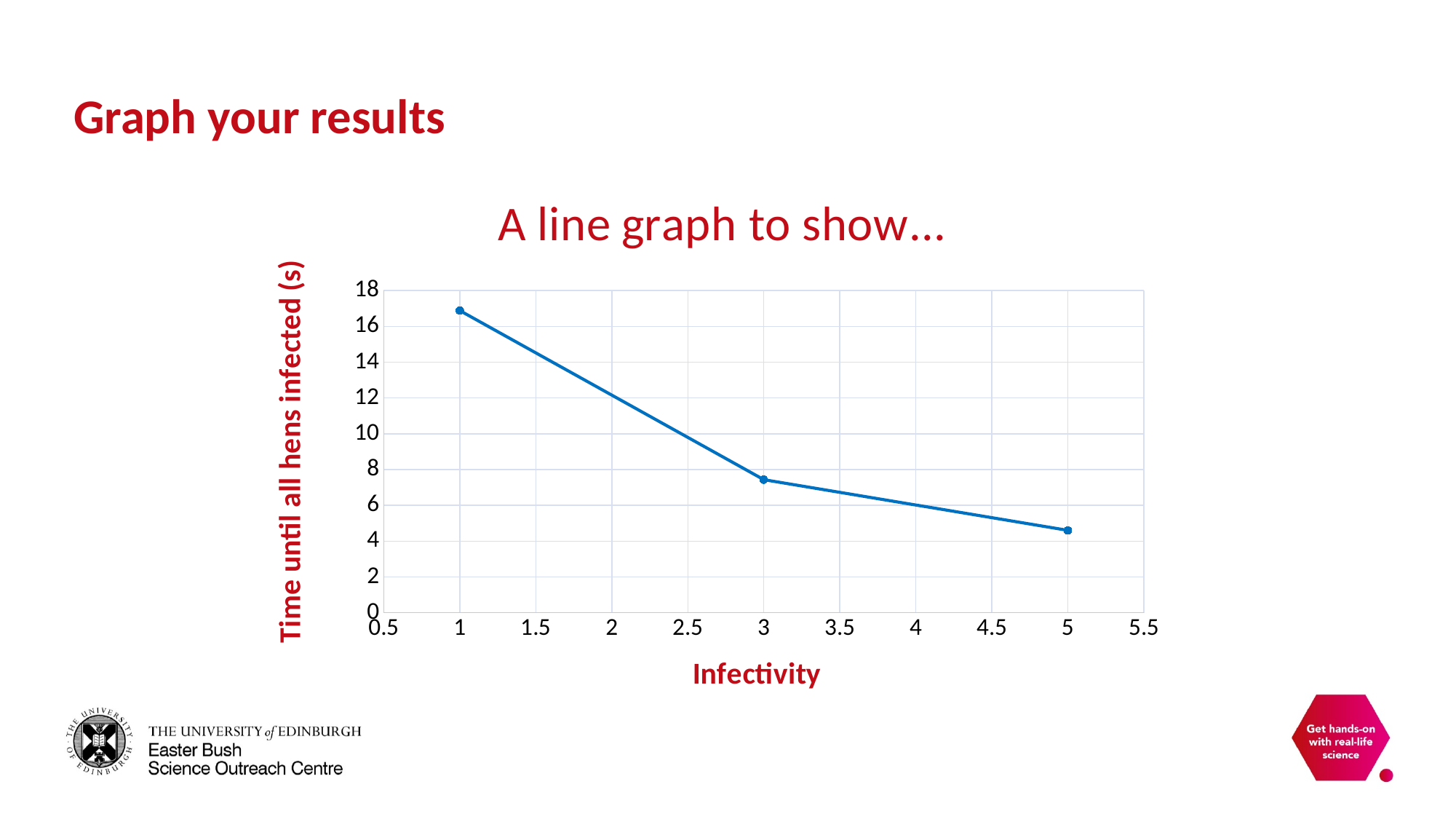
At which infectivity value is the time until all hens infected highest? 1 Is the time until all hens infected at infectivity 1 greater or less than 16? greater Is the time until all hens infected at infectivity 5 greater or less than 6? less What kind of chart is shown on the slide? line chart What is the title of the chart? A line graph to show... At which infectivity value is the time until all hens infected lowest? 5 Is the time until all hens infected at infectivity 3 greater or less than 8? less What is the label of the y axis? Time until all hens infected (s) How many data points are plotted on the line? 3 Does the time until all hens are infected rise or fall as infectivity increases? fall Which has a larger time until all hens infected: infectivity 1 or infectivity 3? infectivity 1